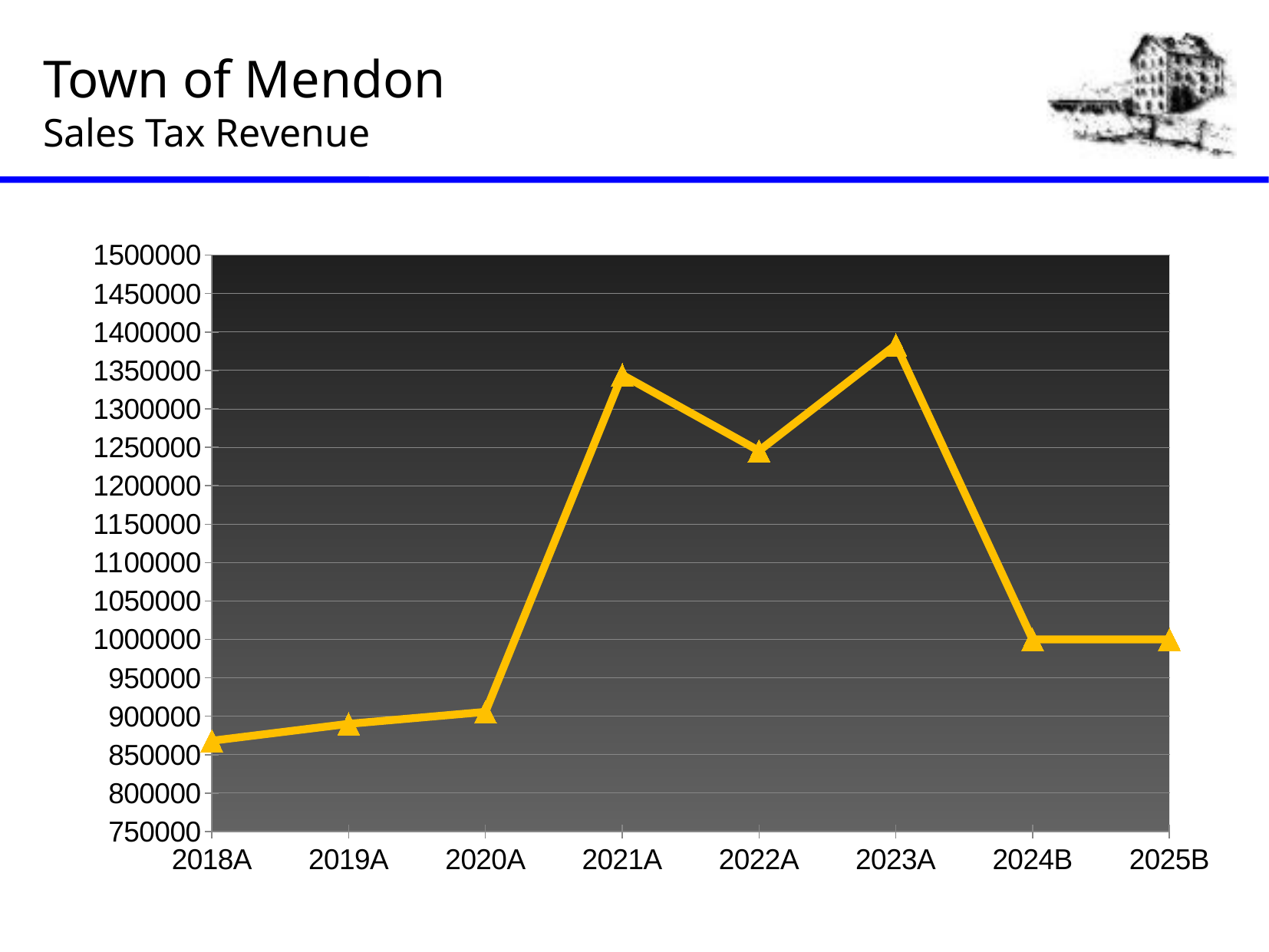
Which year has the highest sales tax revenue? 2023A What kind of chart is shown on the slide? line chart How many years are plotted along the x axis? 8 What is the value for 2025B? 1000000 Is the value for 2021A greater or less than 1300000? greater Is the value for 2023A greater or less than 1350000? greater What is the value for 2024B? 1000000 Which is larger, the value for 2021A or the value for 2022A? 2021A Is the value for 2022A greater or less than 1300000? less Which year has the lowest sales tax revenue? 2018A Do the values rise or fall from 2018A to 2020A? rise